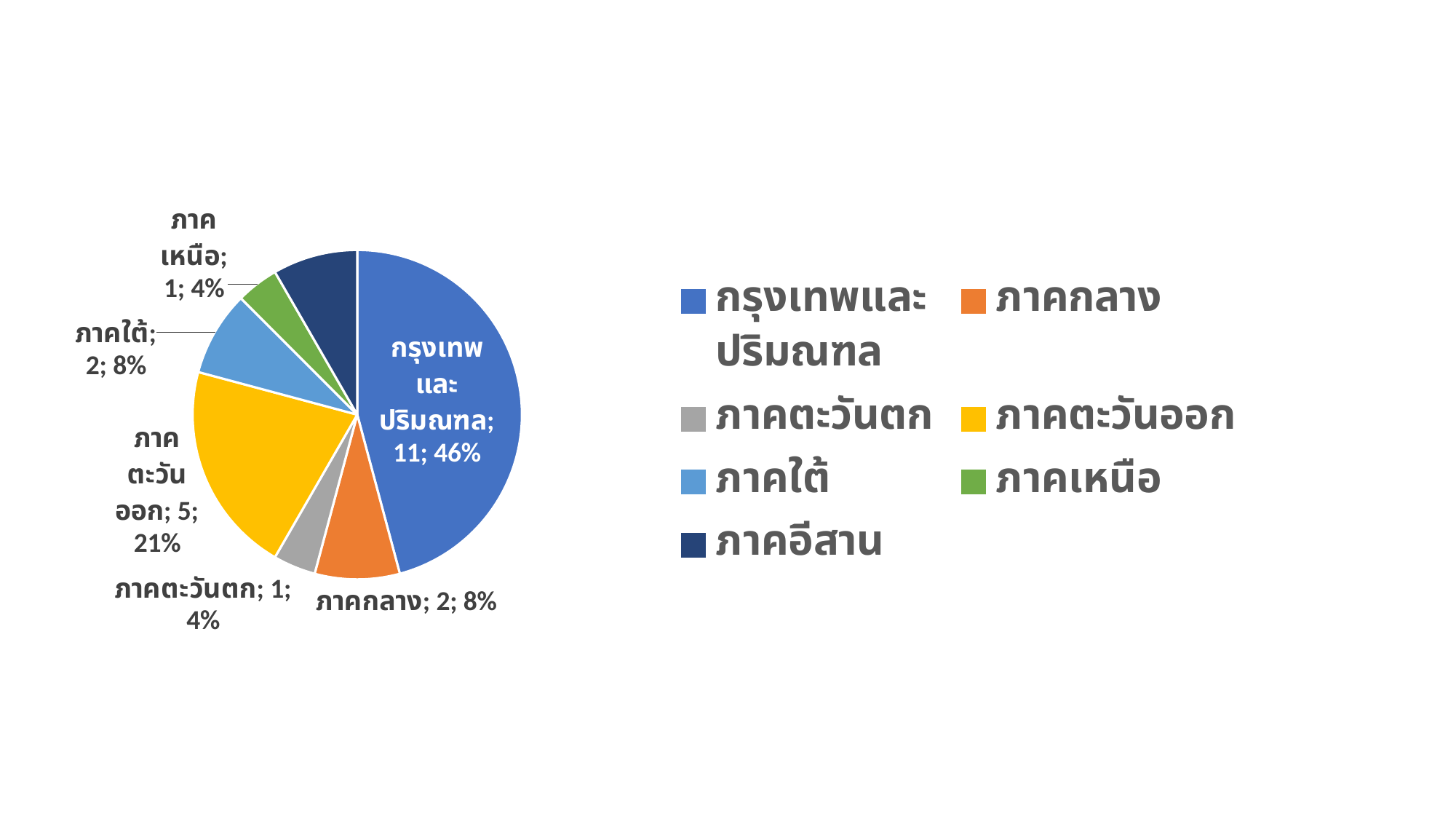
What colour is the slice for ภาคตะวันออก? yellow How many categories does the legend list? 7 What value is shown for ภาคกลาง in the pie chart? 2 What percentage share does ภาคใต้ have in the pie chart? 8% What percentage share does ภาคตะวันออก have in the pie chart? 21% What value is shown for ภาคตะวันออก in the pie chart? 5 Which is larger, the value for ภาคตะวันออก or the value for ภาคกลาง? ภาคตะวันออก Which category has the largest slice in the pie chart? กรุงเทพและปริมณฑล What kind of chart is shown on the slide? pie chart What percentage share does กรุงเทพและปริมณฑล have in the pie chart? 46% What is the difference between the values for กรุงเทพและปริมณฑล and ภาคตะวันออก? 6 What value is shown for กรุงเทพและปริมณฑล in the pie chart? 11